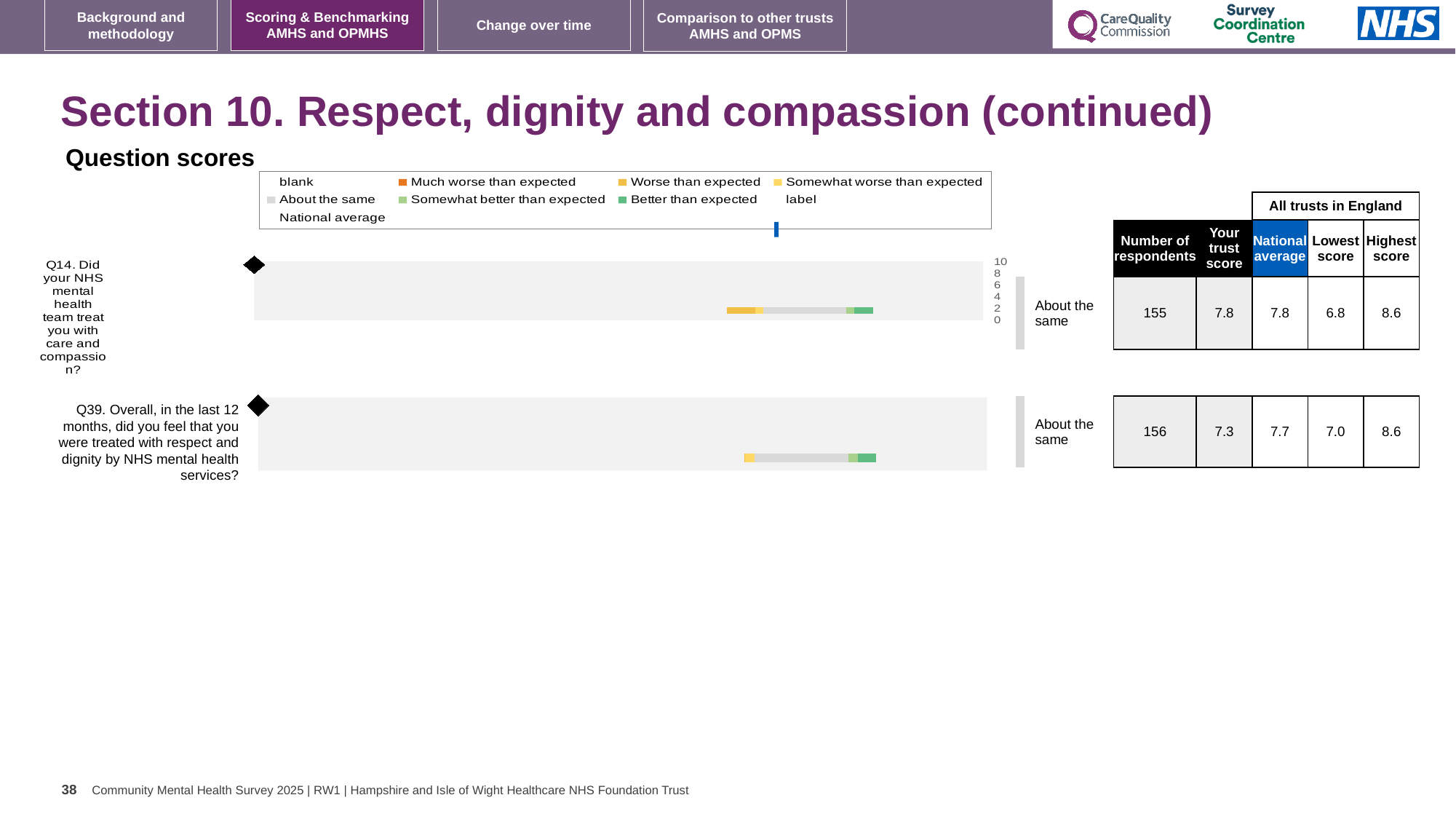
What is the trust score for Q14 (care and compassion)? 7.8 Which legend entry is shown in dark green? Better than expected What benchmark category is shown next to the bar for Q39? About the same What is the highest score across all trusts in England for Q39? 8.6 What is the lowest score across all trusts in England for Q14? 6.8 Which question has the higher trust score, Q14 or Q39? Q14 How many respondents answered Q14? 155 How many questions are plotted in the Question scores chart? 2 What is the difference between the national average and the trust score for Q39? 0.4 What is the national average for Q39? 7.7 What is the trust score for Q39 (treated with respect and dignity)? 7.3 What kind of chart is shown under 'Question scores'? bar chart